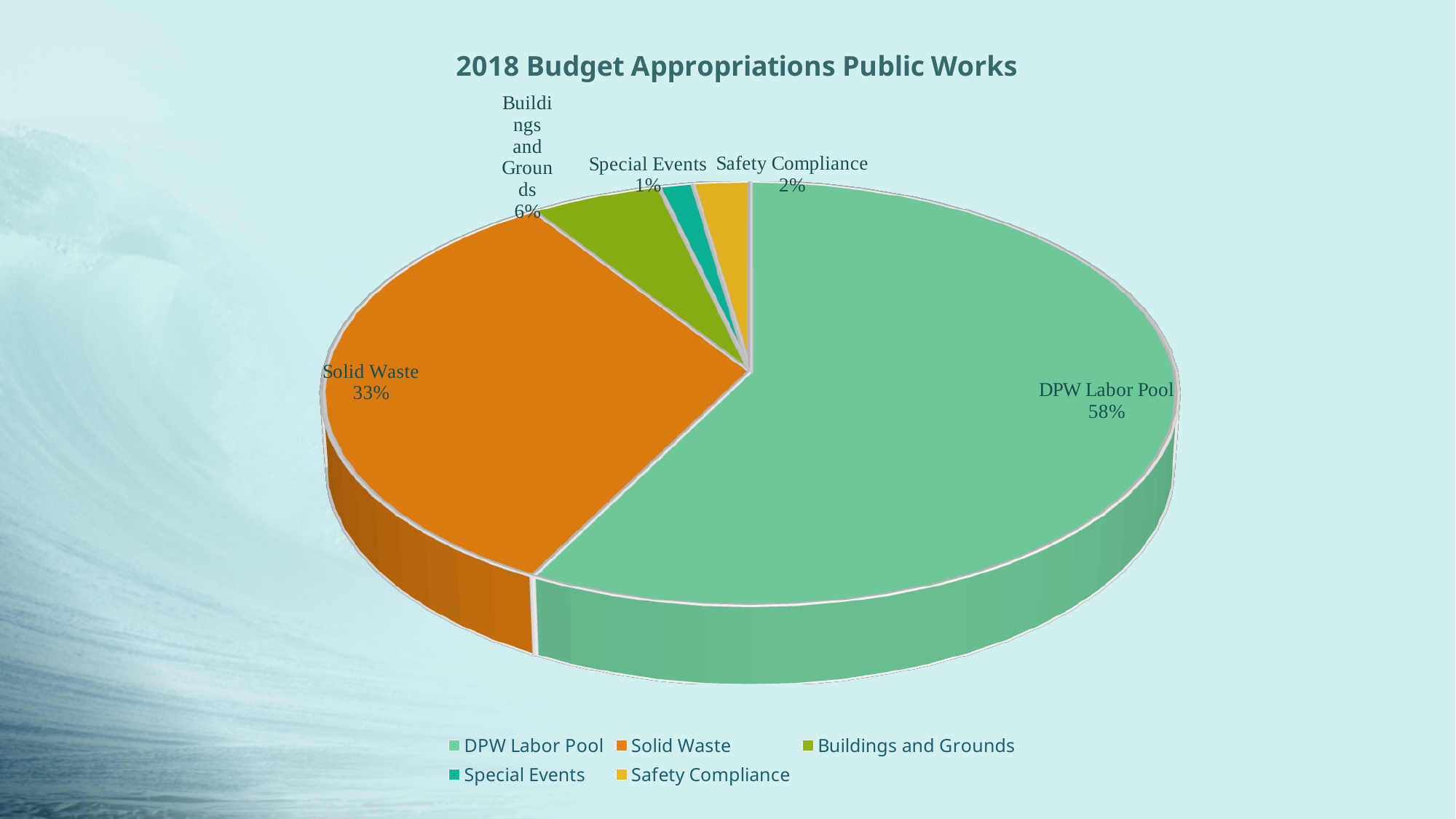
What is the difference in percentage points between DPW Labor Pool and Solid Waste? 25 What share of the pie does DPW Labor Pool represent? 58% What kind of chart is shown on the slide? pie chart What share of the pie does Safety Compliance represent? 2% Which is larger, Buildings and Grounds or Safety Compliance? Buildings and Grounds What share of the pie does Buildings and Grounds represent? 6% Which category has the smallest slice of the pie? Special Events What is the title of the chart? 2018 Budget Appropriations Public Works Which category has the largest slice of the pie? DPW Labor Pool How many categories does the legend list? 5